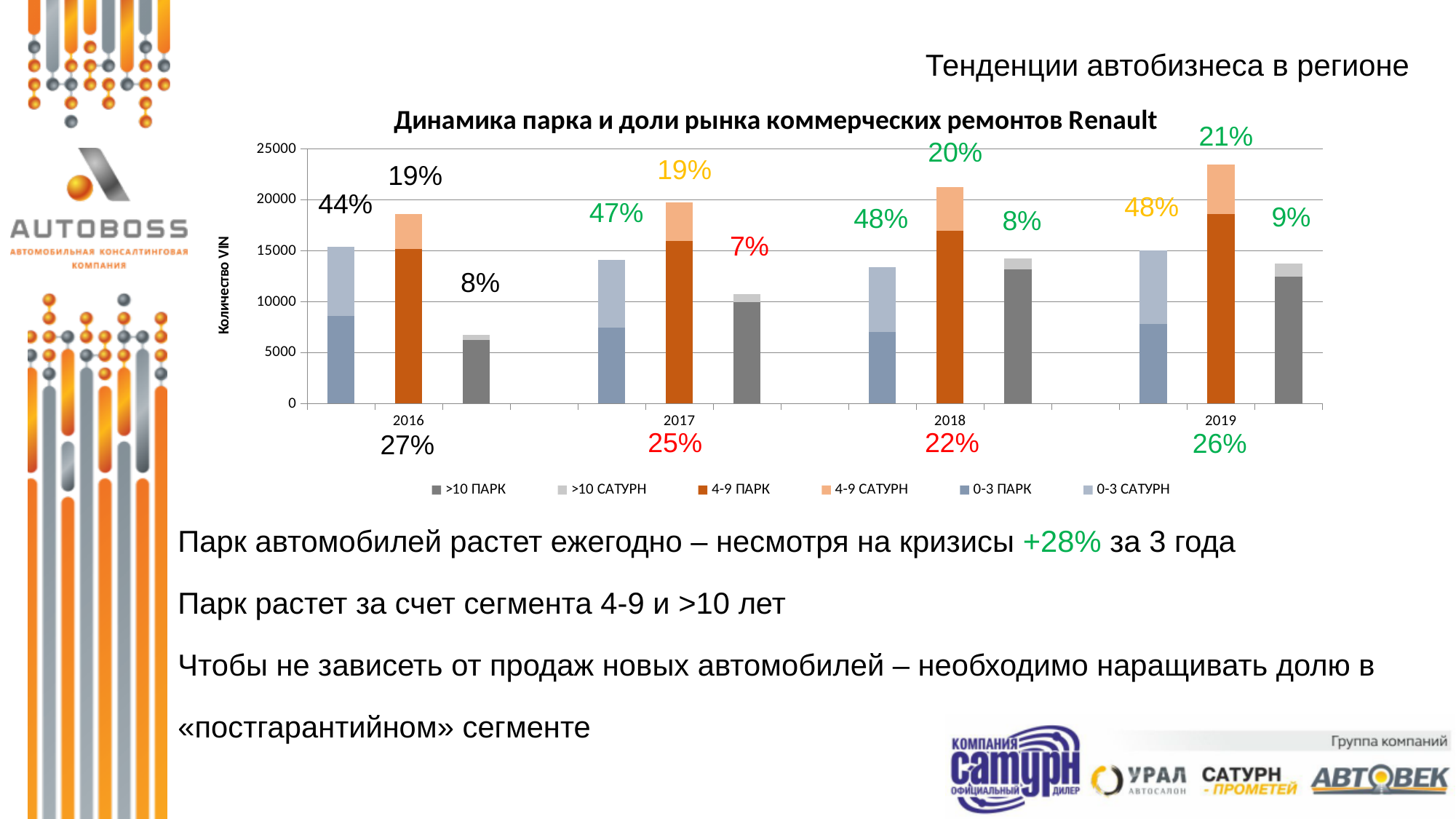
In which year is the >10 stacked bar the shortest? 2016 In which year is the 4-9 stacked bar (4-9 ПАРК plus 4-9 САТУРН) the tallest? 2019 Is the total height of the 4-9 stacked bar for 2019 greater or less than 20000? greater What is the label of the vertical axis? Количество VIN Does the total height of the 4-9 stacked bar rise or fall from 2016 to 2019? rise Is the total height of the 4-9 stacked bar (4-9 ПАРК plus 4-9 САТУРН) for 2016 greater or less than 15000? greater How many series does the legend list? 6 Is the total height of the 0-3 stacked bar for 2018 greater or less than 15000? less What kind of chart is shown on the slide? stacked bar chart How many years are shown on the x axis? 4 What is the title of the chart? Динамика парка и доли рынка коммерческих ремонтов Renault